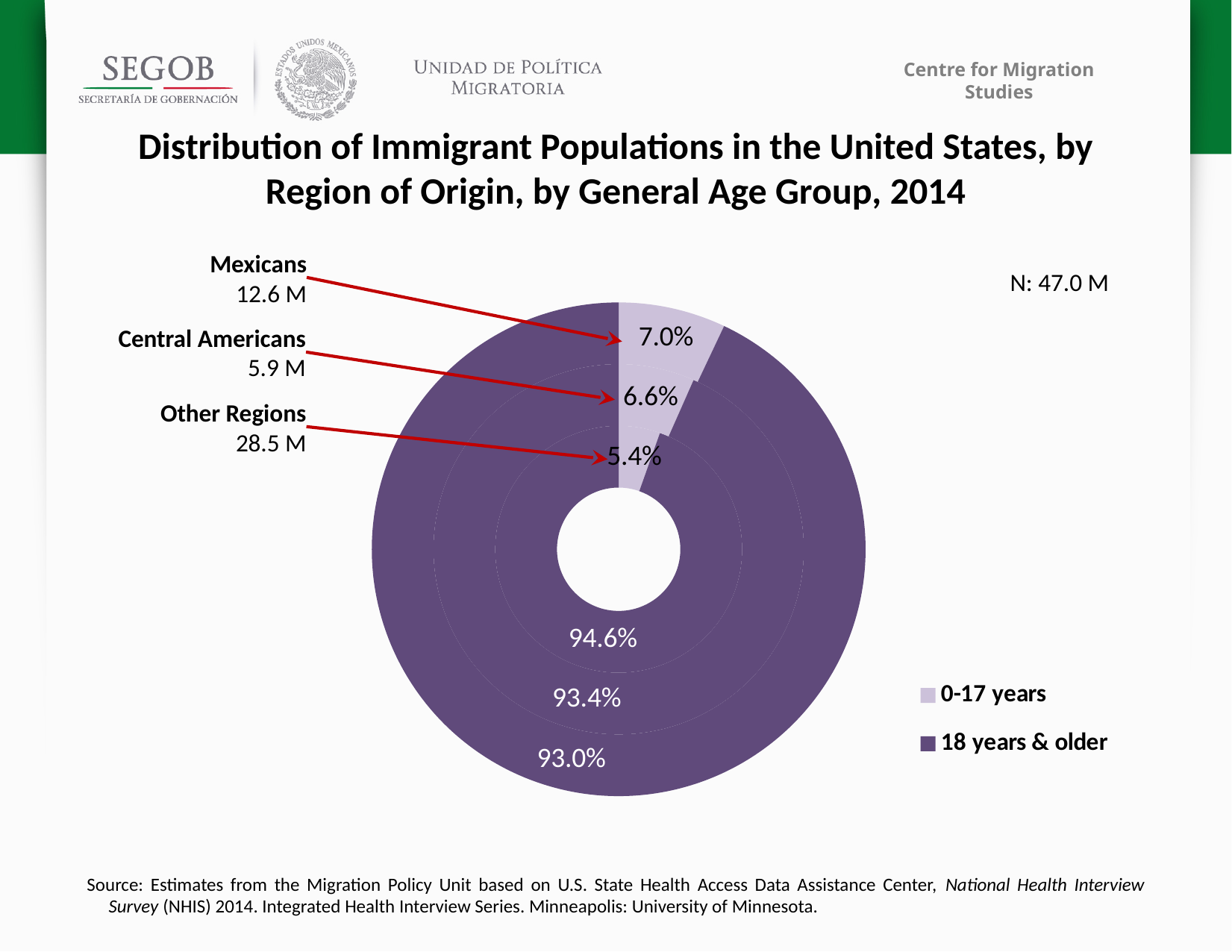
What is the total population size (N) shown on the slide? 47.0 M Which is larger: the 18 years & older share for Mexicans or for Other Regions? Other Regions What is the difference between the 0-17 years share for Mexicans and for Central Americans? 0.4% Which region of origin has the lowest share of immigrants aged 0-17 years? Other Regions How many age groups does the legend list? 2 How many regions of origin are shown in the chart? 3 What kind of chart is shown on the slide? Doughnut chart What share of the Mexican immigrant population is aged 0-17 years? 7.0% What share of the Central American immigrant population is aged 18 years & older? 93.4% What share of immigrants from Other Regions is aged 0-17 years? 5.4% What share of immigrants from Other Regions is aged 18 years & older? 94.6% Which region of origin has the highest share of immigrants aged 0-17 years? Mexicans